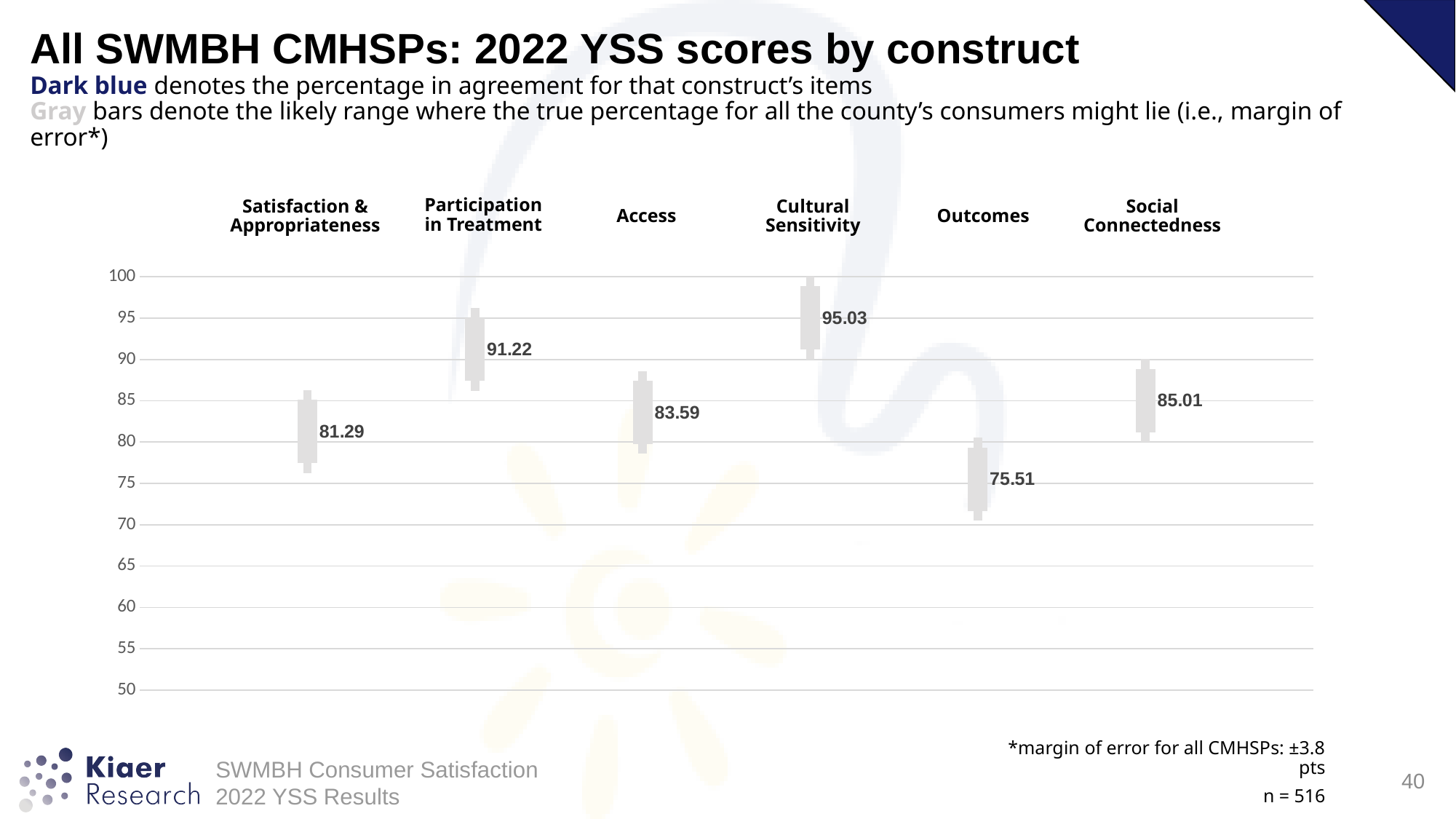
How many constructs are shown on the chart? 6 Which construct has the lowest score? Outcomes What is the 2022 YSS score for Outcomes? 75.51 According to the footnote, what is the margin of error for all CMHSPs? ±3.8 pts What is the 2022 YSS score for Cultural Sensitivity? 95.03 What is the difference between the Cultural Sensitivity score and the Outcomes score? 19.52 Which construct has the highest score? Cultural Sensitivity Which has a higher score, Satisfaction & Appropriateness or Access? Access What is the difference between the Social Connectedness score and the Access score? 1.42 What is the score shown for Participation in Treatment? 91.22 What is the score shown for Social Connectedness? 85.01 Is the score for Participation in Treatment greater or less than 90? greater